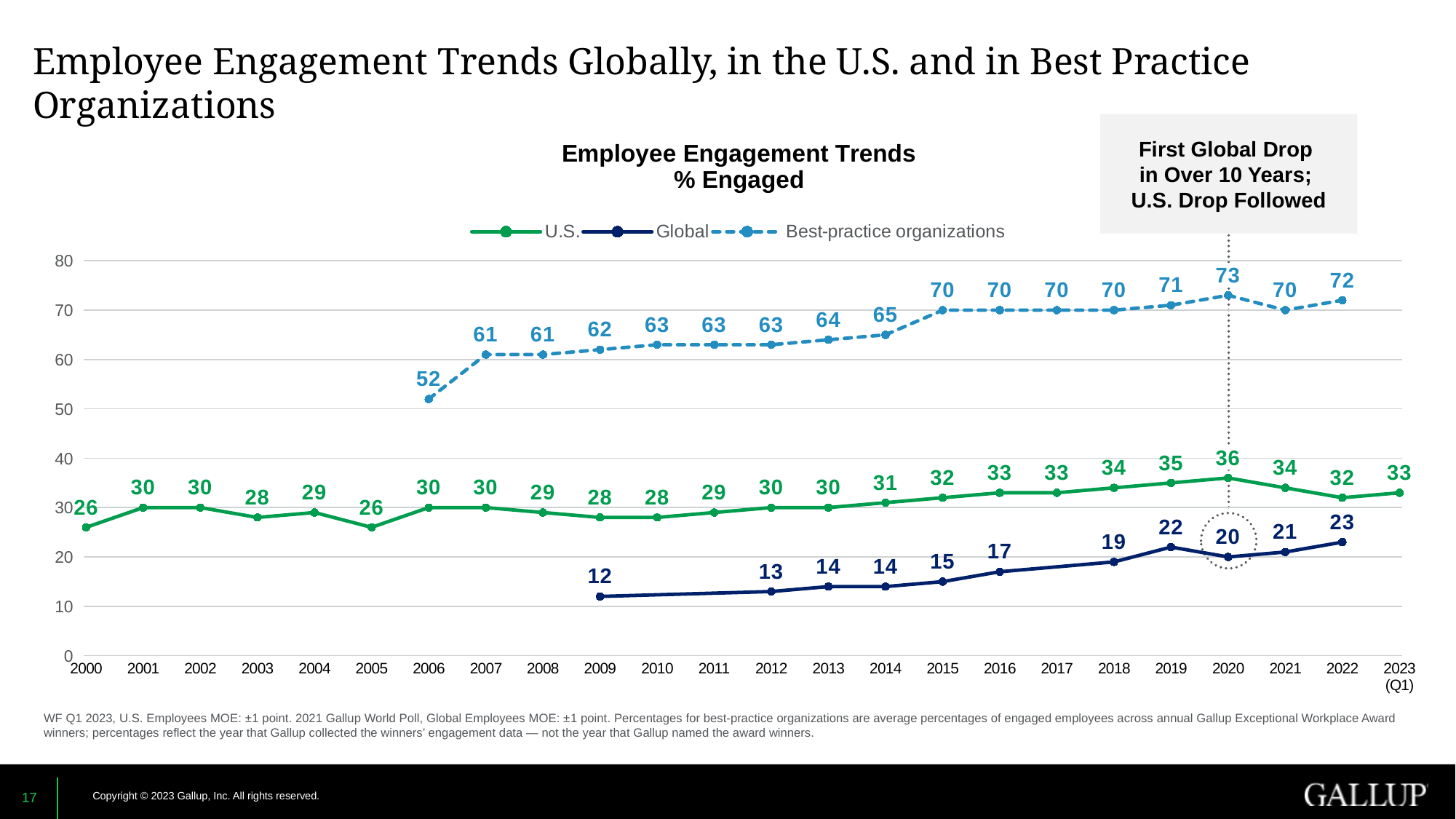
What is the lowest value shown for the Global series? 12 What is the difference between the Best-practice organizations value and the U.S. value in 2022? 40 How many series does the legend list? 3 What is the title of the chart? Employee Engagement Trends % Engaged What is the U.S. value for 2020? 36 What kind of chart is shown? Line chart In which year does the Best-practice organizations series reach its highest value? 2020 Which is larger in 2019: the U.S. value or the Global value? U.S. What is the Global value for 2009? 12 What is the value for Best-practice organizations in 2006? 52 Is the Best-practice organizations value for 2015 greater or less than 60? greater Does the Global series rise or fall from 2009 to 2019? Rise